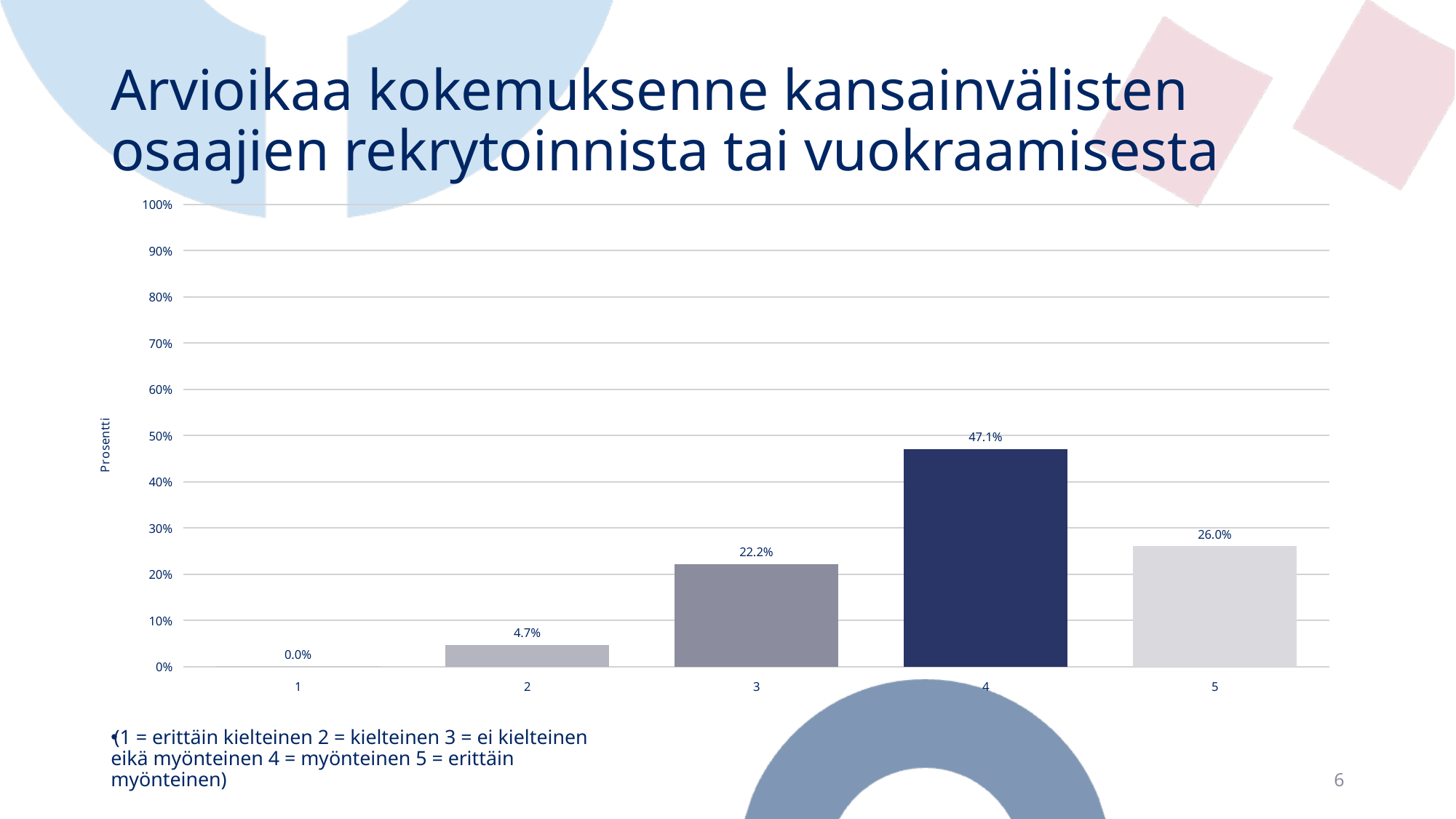
What is the difference between the values for category 4 and category 5? 21.1% What kind of chart is shown on the slide? bar chart What is the value for category 4? 47.1% Which is larger, the value for category 3 or category 5? 5 What is the label of the y axis? Prosentti What is the value for category 2? 4.7% How many categories are shown on the x axis? 5 What is the value for category 5? 26.0% Which category has the lowest value? 1 Is the value for category 4 greater or less than 40%? greater What is the value for category 1? 0.0% Which category has the highest value? 4